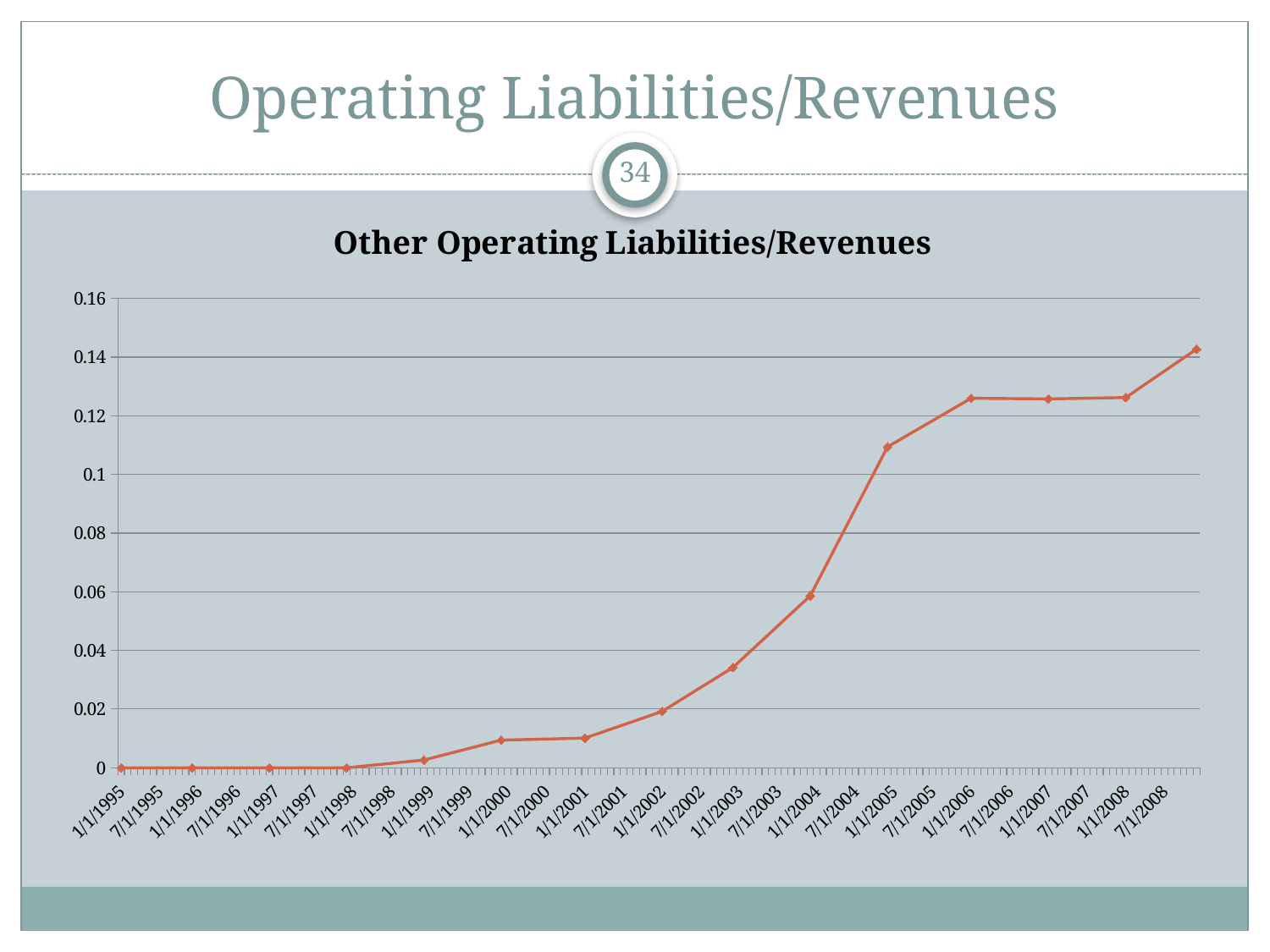
Is the value for 1/1/2006 greater or less than 0.12? greater Is the value for 1/1/2003 greater or less than 0.04? less Which has the larger value, 1/1/2002 or 1/1/2003? 1/1/2003 What type of chart is shown on the slide? Line chart Is the value for 1/1/2004 greater or less than 0.04? greater What is the value for 1/1/1997? 0 What is the title of the chart? Other Operating Liabilities/Revenues What is the value for 1/1/1995? 0 Do the values generally rise or fall from 1/1/1995 to the end of the series? Rise Which has the larger value, 1/1/2004 or 1/1/2005? 1/1/2005